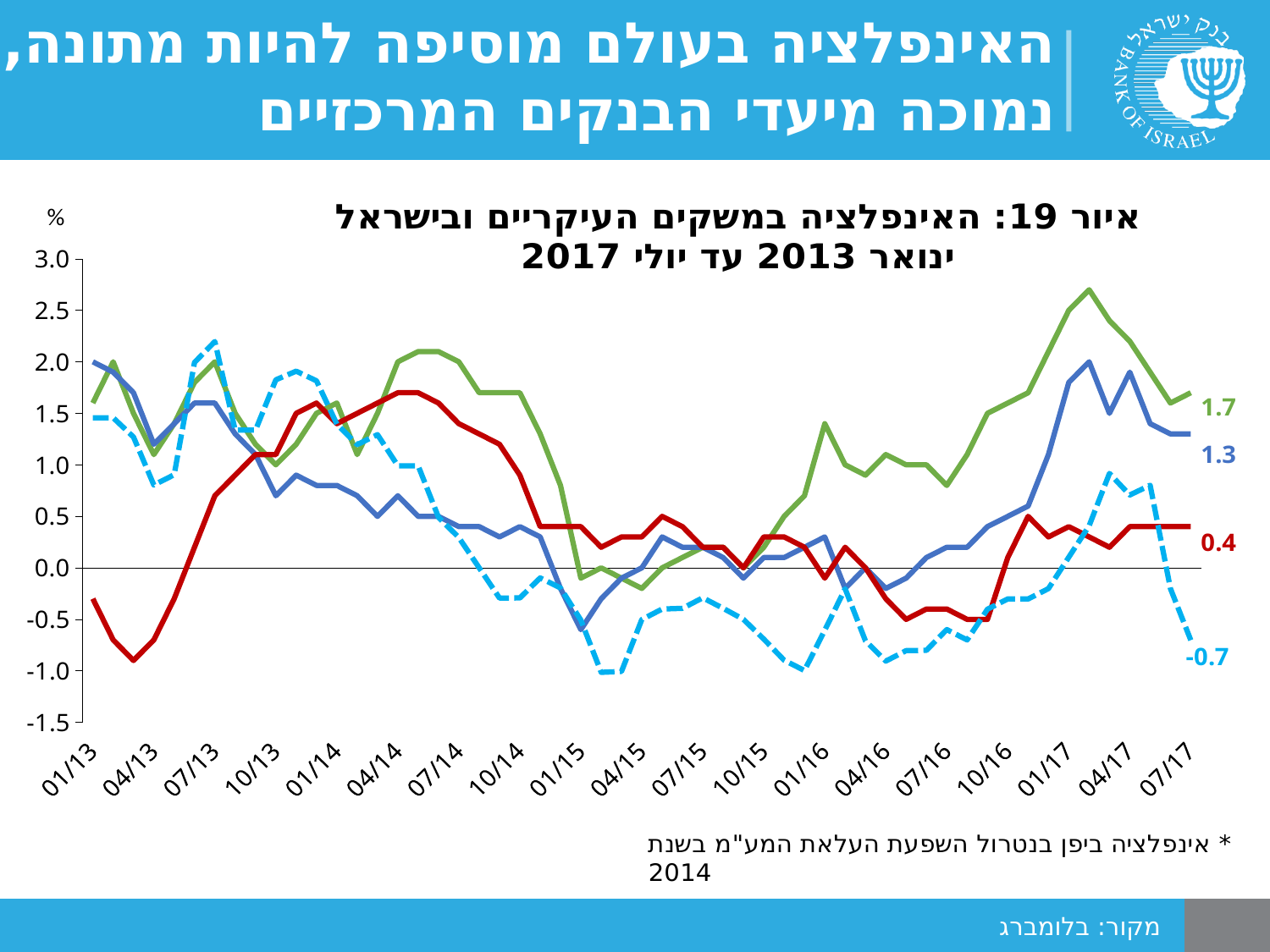
Is the value of the red line at 04/13 greater or less than -0.5? less What unit is shown on the vertical axis of the chart? % How many lines are plotted on the chart? 4 What is the value labelled at the end of the green line (07/17)? 1.7 What is the difference between the end values of the green line (1.7) and the solid blue line (1.3)? 0.4 What is the value labelled at the end of the solid blue line (07/17)? 1.3 What kind of chart is shown on the slide? line chart Which line has the highest value at the end of the period (07/17)? the green line Which line has the lowest value at the end of the period (07/17)? the dashed light-blue line What is the value labelled at the end of the dashed light-blue line (07/17)? -0.7 What is the value labelled at the end of the red line (07/17)? 0.4 Is the peak value of the green line around 01/17 greater or less than 2.5? greater